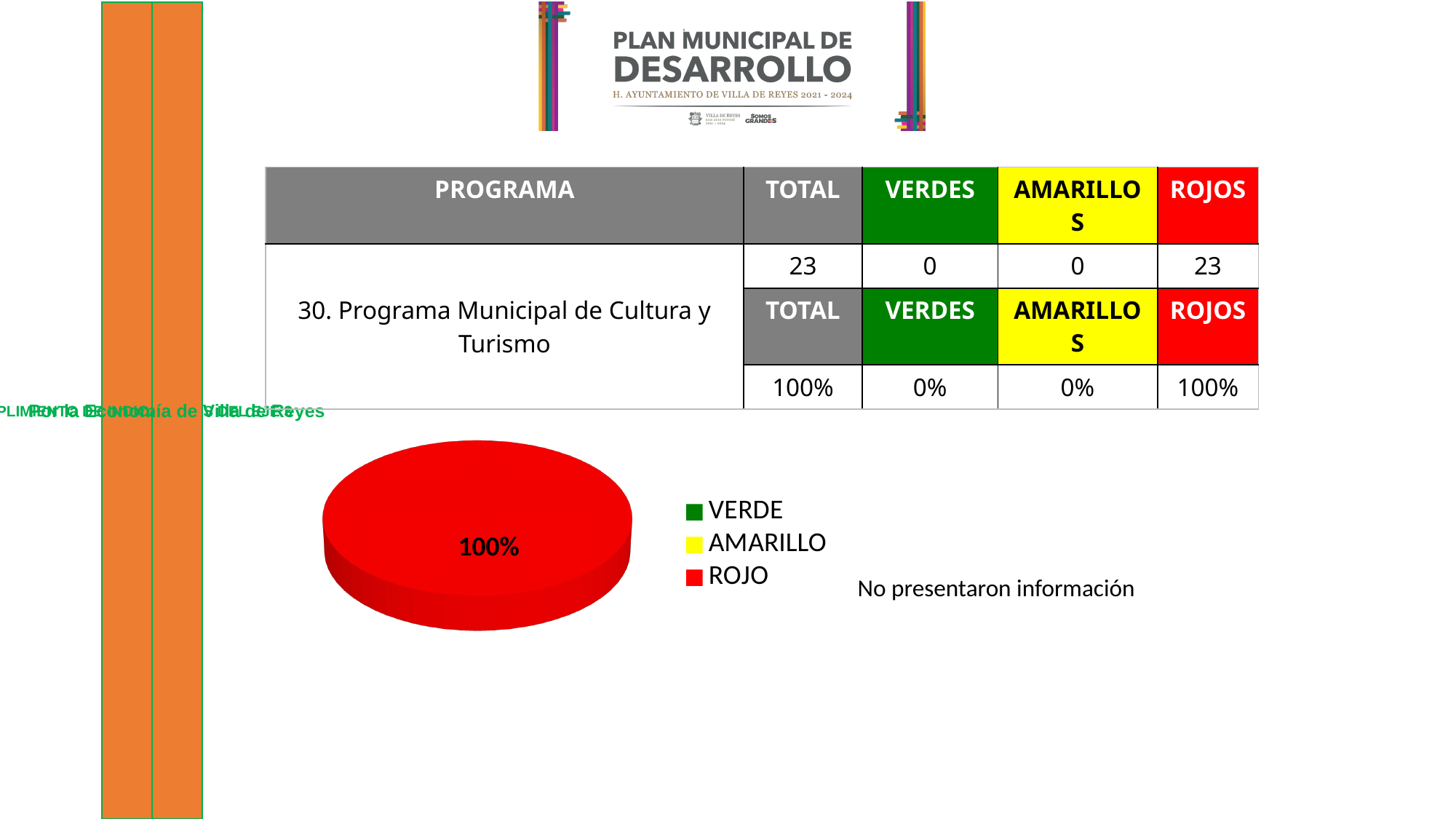
What share of the pie chart does ROJO represent? 100% How many entries does the legend of the pie chart list? 3 Which legend entries are listed for the pie chart? VERDE, AMARILLO, ROJO Which category has the largest share of the pie chart? ROJO How many slices are visible in the pie chart? 1 What colour is the ROJO slice in the pie chart? red What kind of chart is shown on the slide? pie chart What value is printed as the data label on the pie chart? 100%